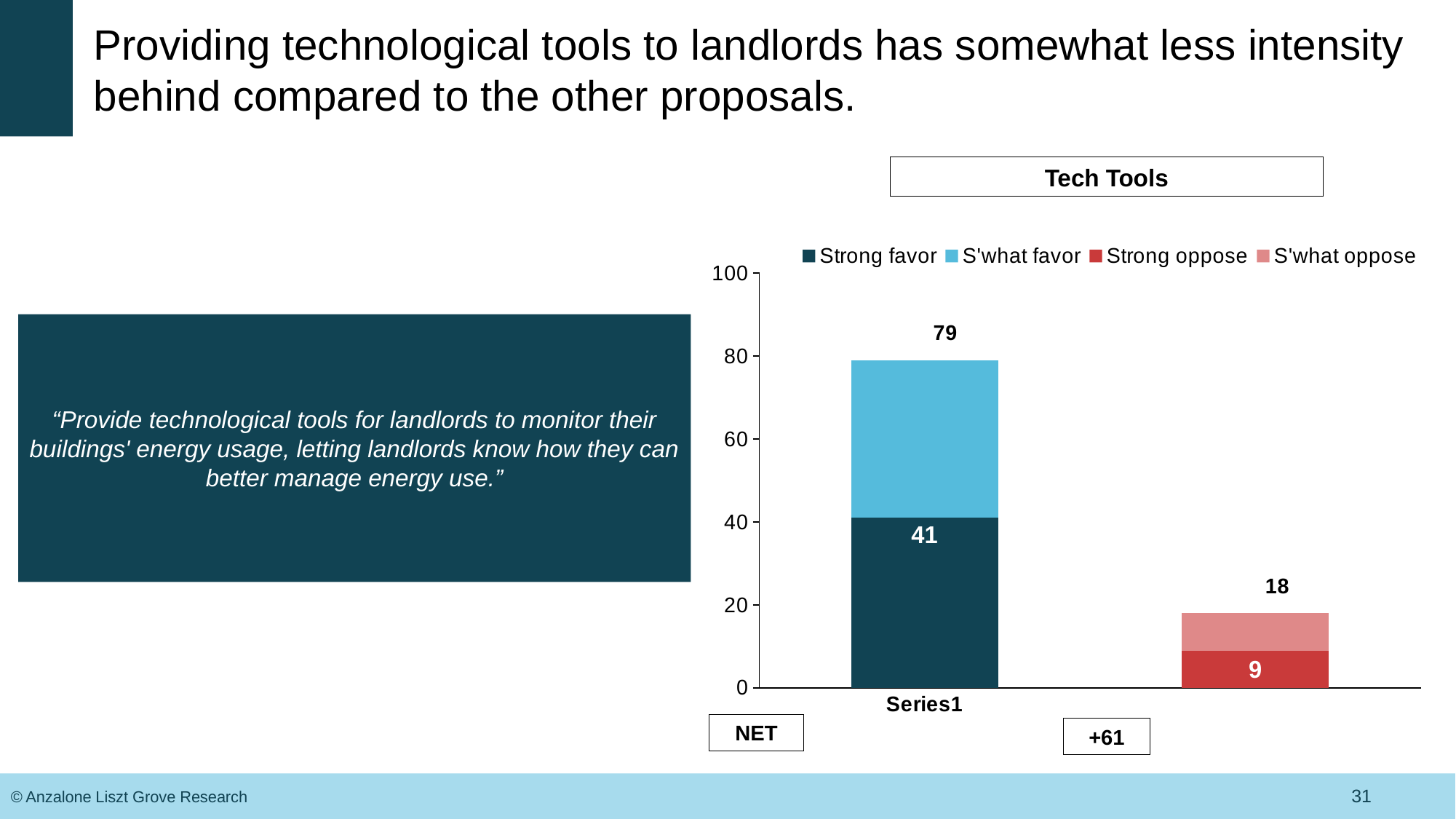
What is the value labelled for Strong favor? 41 Which is larger, the Strong favor value or the Strong oppose value? Strong favor What type of chart is shown on the slide? stacked bar chart Is the total of the favor bar greater or less than 60? greater How many series does the chart legend list? 4 What is the difference between the favor bar total (79) and the Strong favor value (41)? 38 What is the total of the favor bar (Strong favor plus S'what favor)? 79 What is the total of the oppose bar (Strong oppose plus S'what oppose)? 18 What is the difference between the favor bar total and the oppose bar total? 61 What is the title of the chart? Tech Tools What is the value labelled for Strong oppose? 9 What NET value is shown below the chart? +61